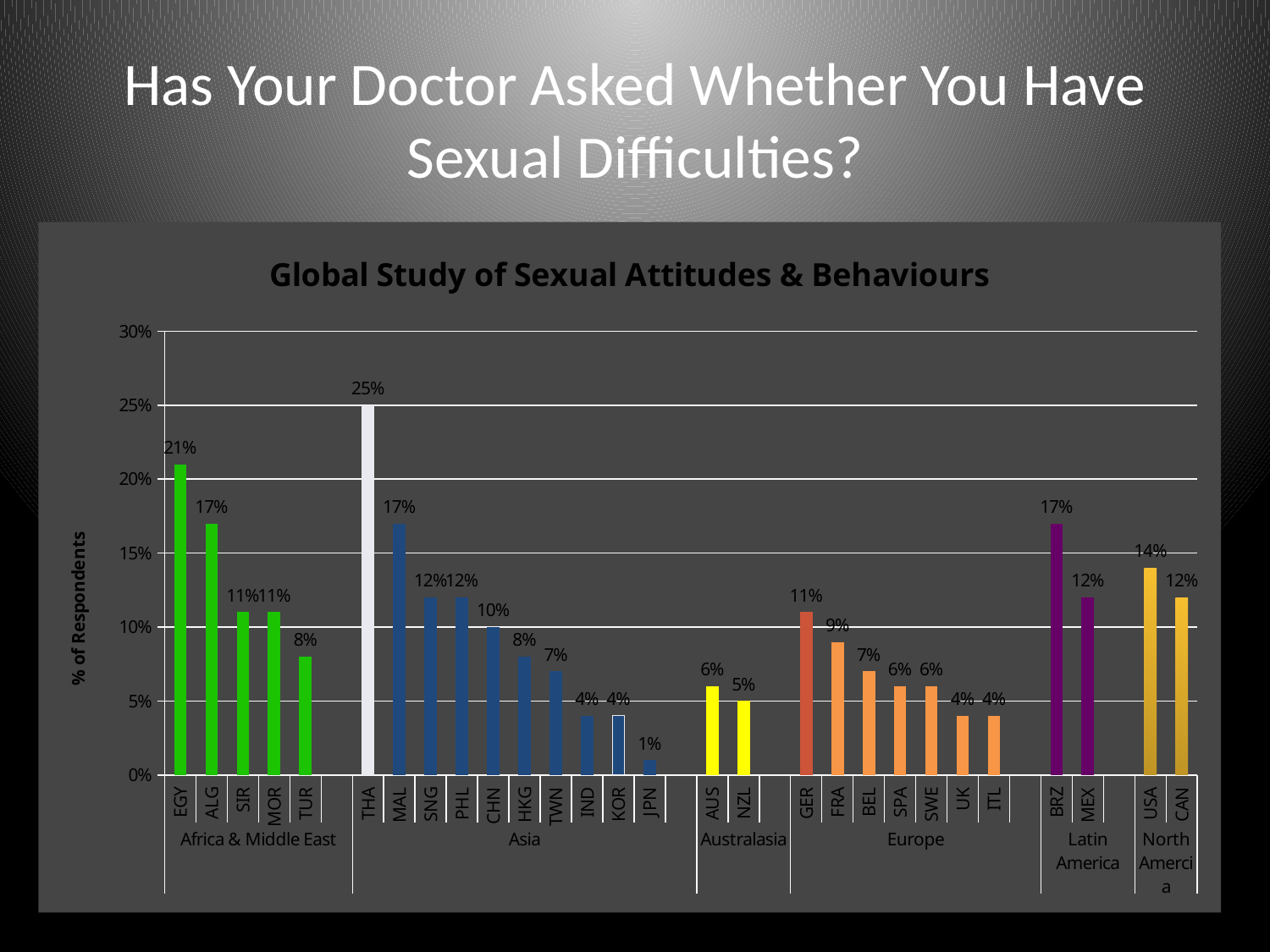
Which is larger, the value for GER or the value for FRA? GER What is the difference between the values for THA and EGY? 4% Which country has the lowest value? JPN How many countries are shown on the chart? 28 What is the value for USA? 14% What is the value for THA? 25% What kind of chart is this? bar chart What is the label of the vertical axis? % of Respondents What is the value for EGY? 21% What is the value for JPN? 1% Is the value for BRZ greater or less than 15%? greater Which country has the highest value? THA